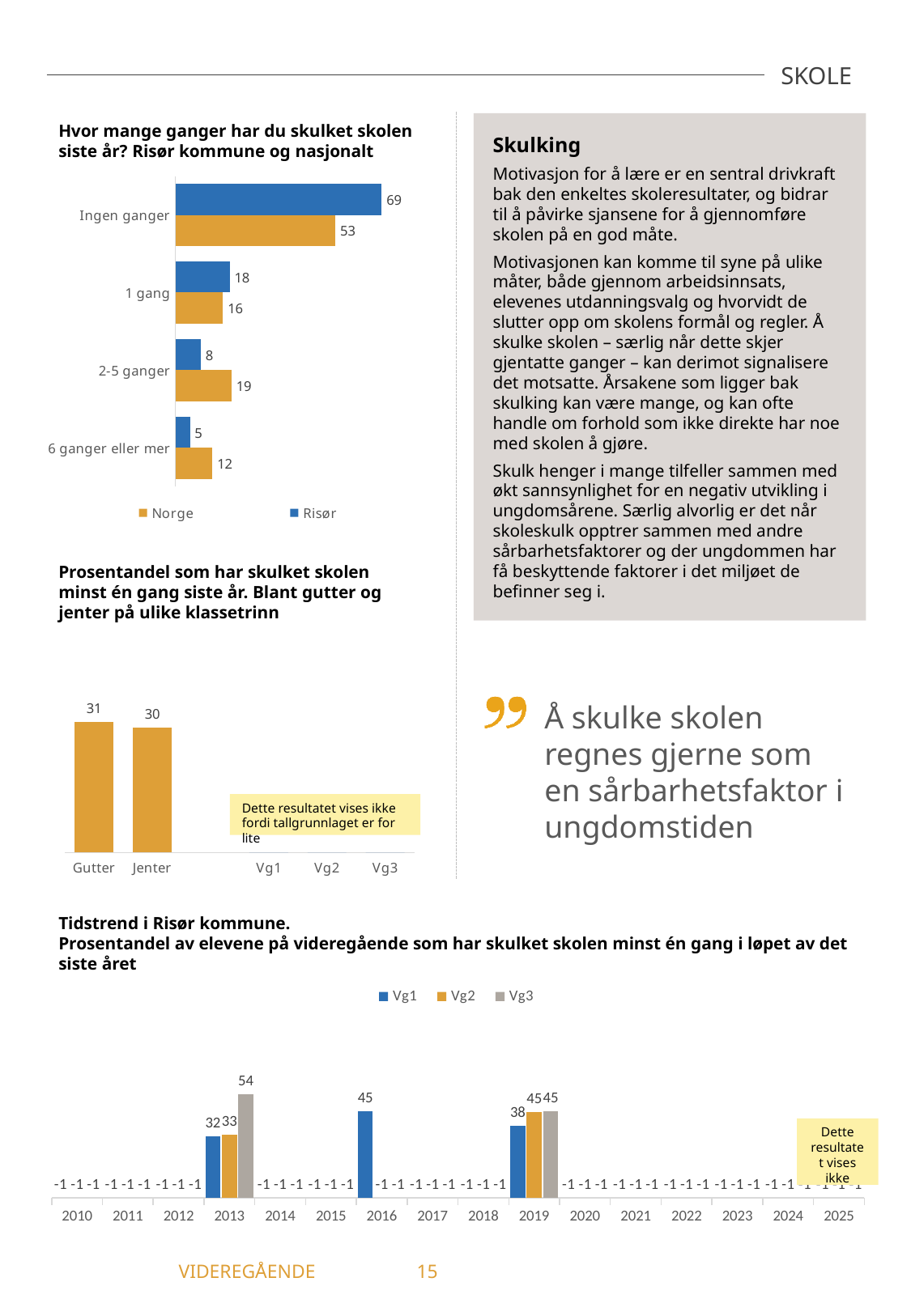
In the chart 'Hvor mange ganger har du skulket skolen siste år?', what is the value for Norge for '2-5 ganger'? 19 In the chart 'Prosentandel som har skulket skolen minst én gang siste år', what is the difference between Gutter and Jenter? 1 In the chart 'Tidstrend i Risør kommune', how many series does the legend list? 3 What kind of chart is 'Hvor mange ganger har du skulket skolen siste år?'? Bar chart In the chart 'Prosentandel som har skulket skolen minst én gang siste år', what is the value for Gutter? 31 In the chart 'Hvor mange ganger har du skulket skolen siste år?', what is the value for Risør for 'Ingen ganger'? 69 In the chart 'Hvor mange ganger har du skulket skolen siste år?', what is the difference between Risør and Norge for 'Ingen ganger'? 16 In the chart 'Tidstrend i Risør kommune', what is the value for Vg1 in 2016? 45 In the chart 'Tidstrend i Risør kommune', what is the value for Vg3 in 2013? 54 In the chart 'Hvor mange ganger har du skulket skolen siste år?', which category has the lowest value for Risør? 6 ganger eller mer In the chart 'Hvor mange ganger har du skulket skolen siste år?', how many series does the legend list? 2 In the chart 'Hvor mange ganger har du skulket skolen siste år?', which is larger for '6 ganger eller mer', Norge or Risør? Norge